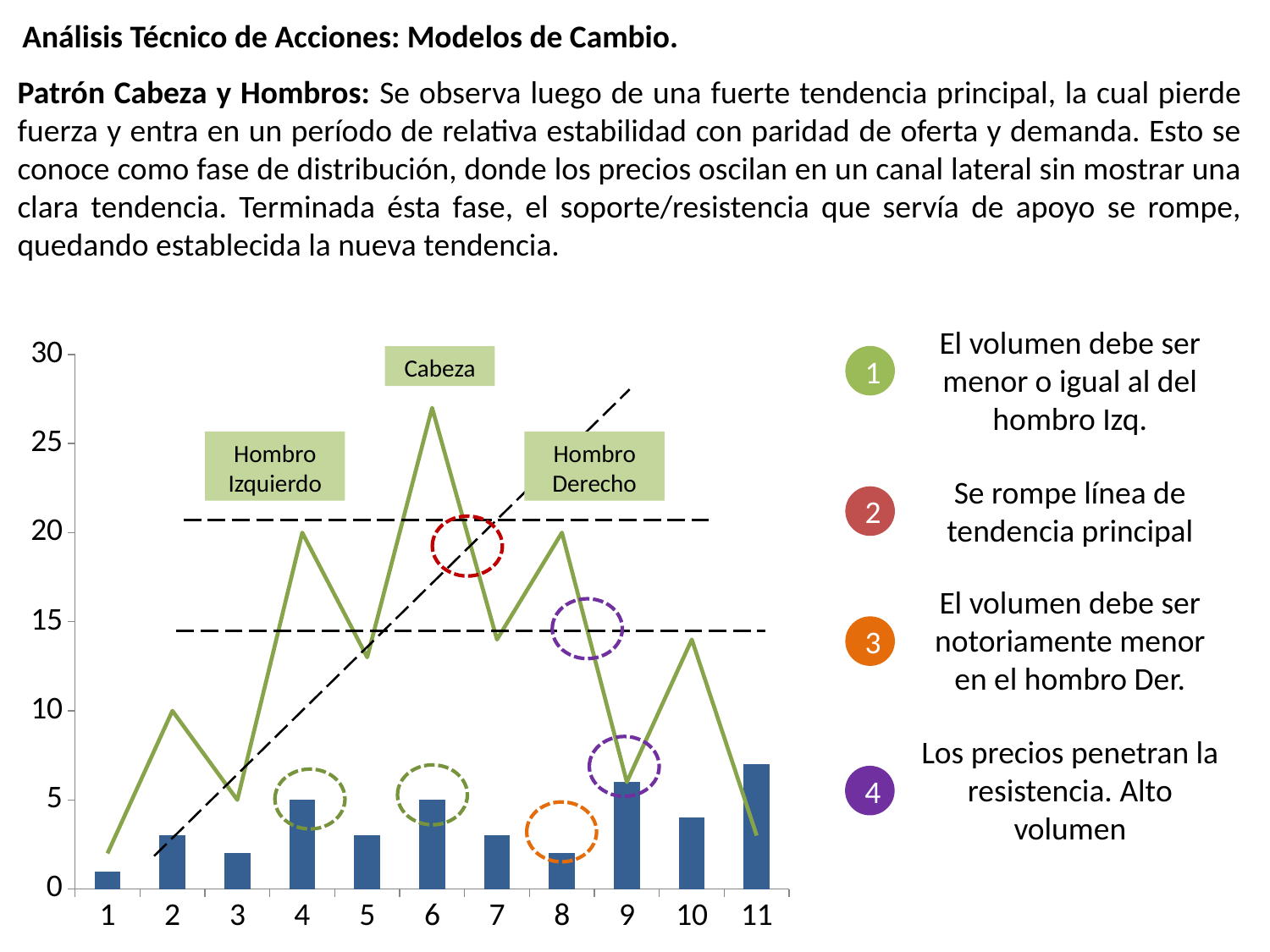
Which x-axis category has the tallest bar? 11 Which bar is taller, the one at category 8 or the one at category 9? 9 What label is shown above the highest peak of the line? Cabeza What is the bar value at category 6? 5 What kind of chart is shown on the slide? Combination bar and line chart At which x-axis category does the line reach its highest value? 6 Which x-axis category has the shortest bar? 1 What is the line value at category 4? 20 How many categories are shown on the x axis of the chart? 11 Is the line value at category 1 greater or less than 5? less Is the bar value at category 11 greater or less than 5? greater Is the line value at category 6 greater or less than 25? greater